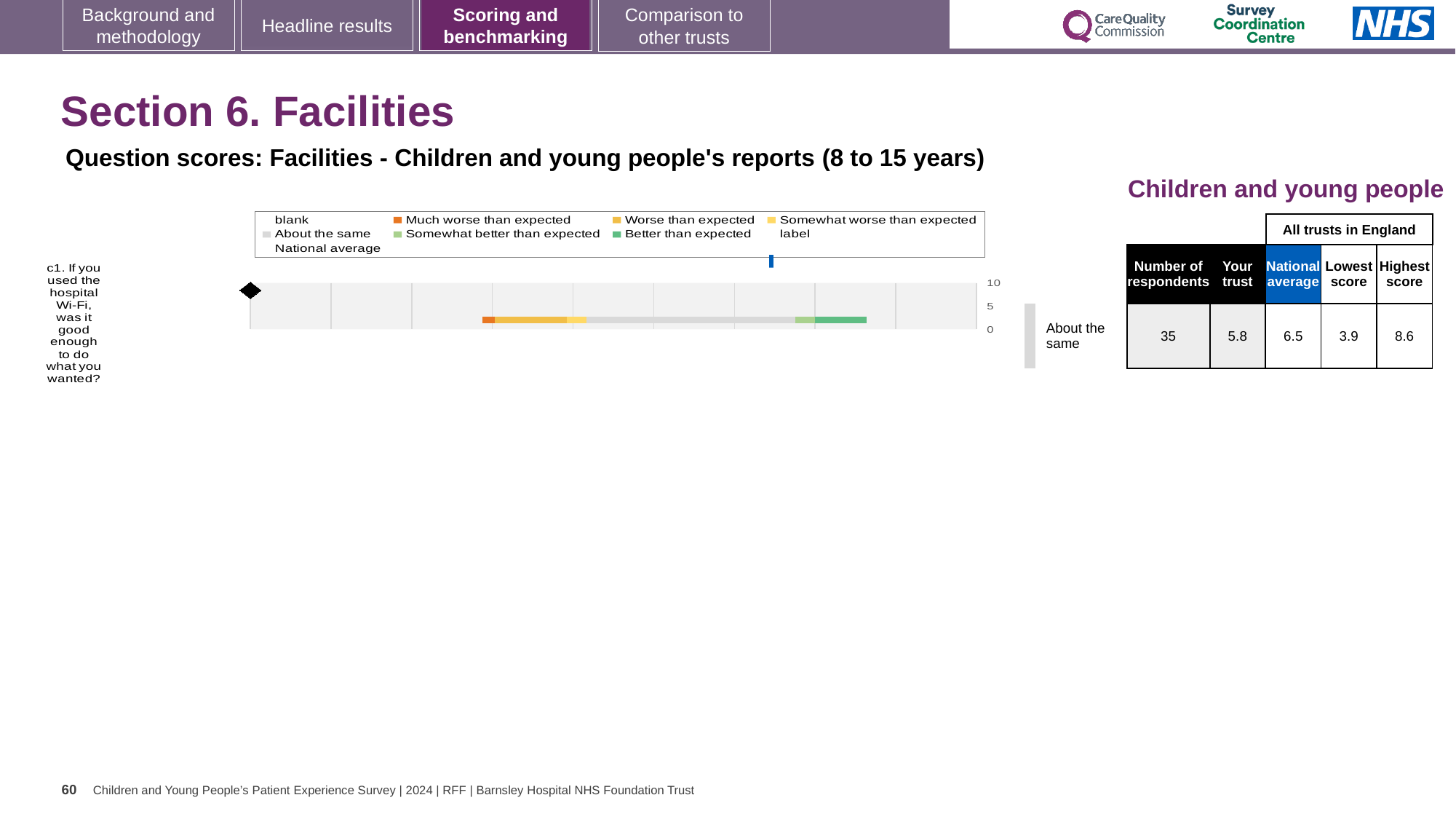
What is the highest score across all trusts in England for question c1? 8.6 What is the lowest score across all trusts in England for question c1? 3.9 Which benchmarking category is the trust's result for question c1 placed in? About the same What kind of chart is used to show the question score for c1 on this slide? bar chart How many respondents answered question c1 about the hospital Wi-Fi? 35 What is the difference between the highest score (8.6) and the lowest score (3.9) for question c1? 4.7 What is the highest value shown on the chart's numeric axis? 10 Which is larger for question c1: the trust's score or the national average? National average What is the difference between the national average (6.5) and the trust's score (5.8) for question c1? 0.7 How many survey questions are plotted in the chart on this slide? 1 What is the 'Your trust' score for question c1 about the hospital Wi-Fi? 5.8 What is the national average score for question c1 about the hospital Wi-Fi? 6.5